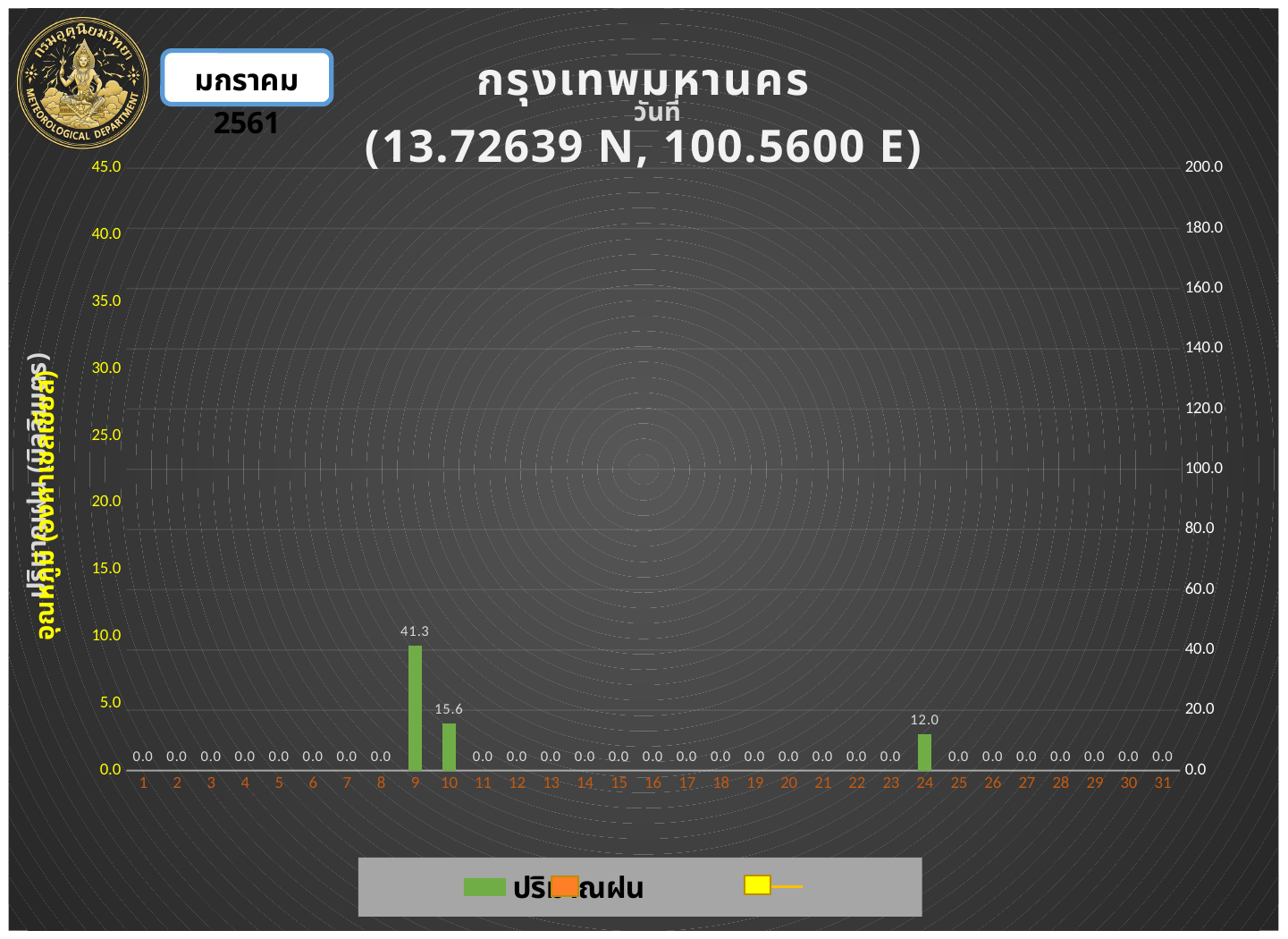
What is the rainfall value shown for day 24? 12.0 What is the rainfall value shown for day 15? 0.0 What is the difference between the rainfall values for day 9 and day 10? 25.7 How many days are shown on the x axis? 31 What kind of chart is shown on the slide? bar chart Which is larger, the rainfall value for day 10 or for day 24? day 10 What are the coordinates shown in the chart title? 13.72639 N, 100.5600 E Is the rainfall value for day 9 greater or less than 40.0 on the right axis? greater What is the rainfall value shown for day 9? 41.3 What is the difference between the rainfall values for day 10 and day 24? 3.6 Which day has the highest rainfall value? 9 What is the rainfall value shown for day 10? 15.6